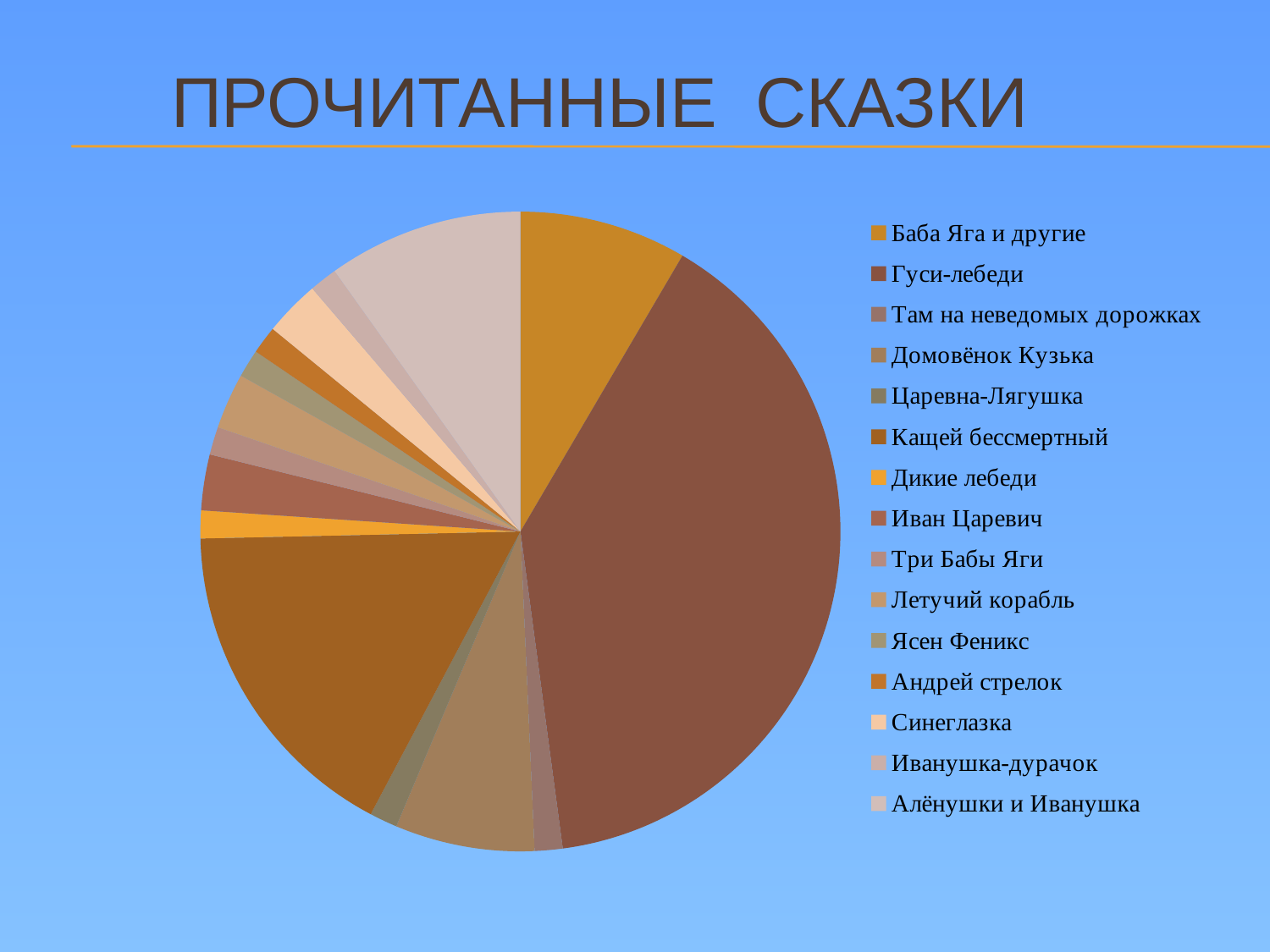
Which category has the largest slice of the pie chart? Гуси-лебеди Where is the legend placed relative to the pie chart? to the right Which slice is larger: Домовёнок Кузька or Царевна-Лягушка? Домовёнок Кузька What is the title of the slide with the pie chart? ПРОЧИТАННЫЕ СКАЗКИ Which slice is larger: Алёнушки и Иванушка or Дикие лебеди? Алёнушки и Иванушка Which slice is larger: Кащей бессмертный or Баба Яга и другие? Кащей бессмертный What kind of chart is shown on the slide? pie chart How many categories does the legend of the pie chart list? 15